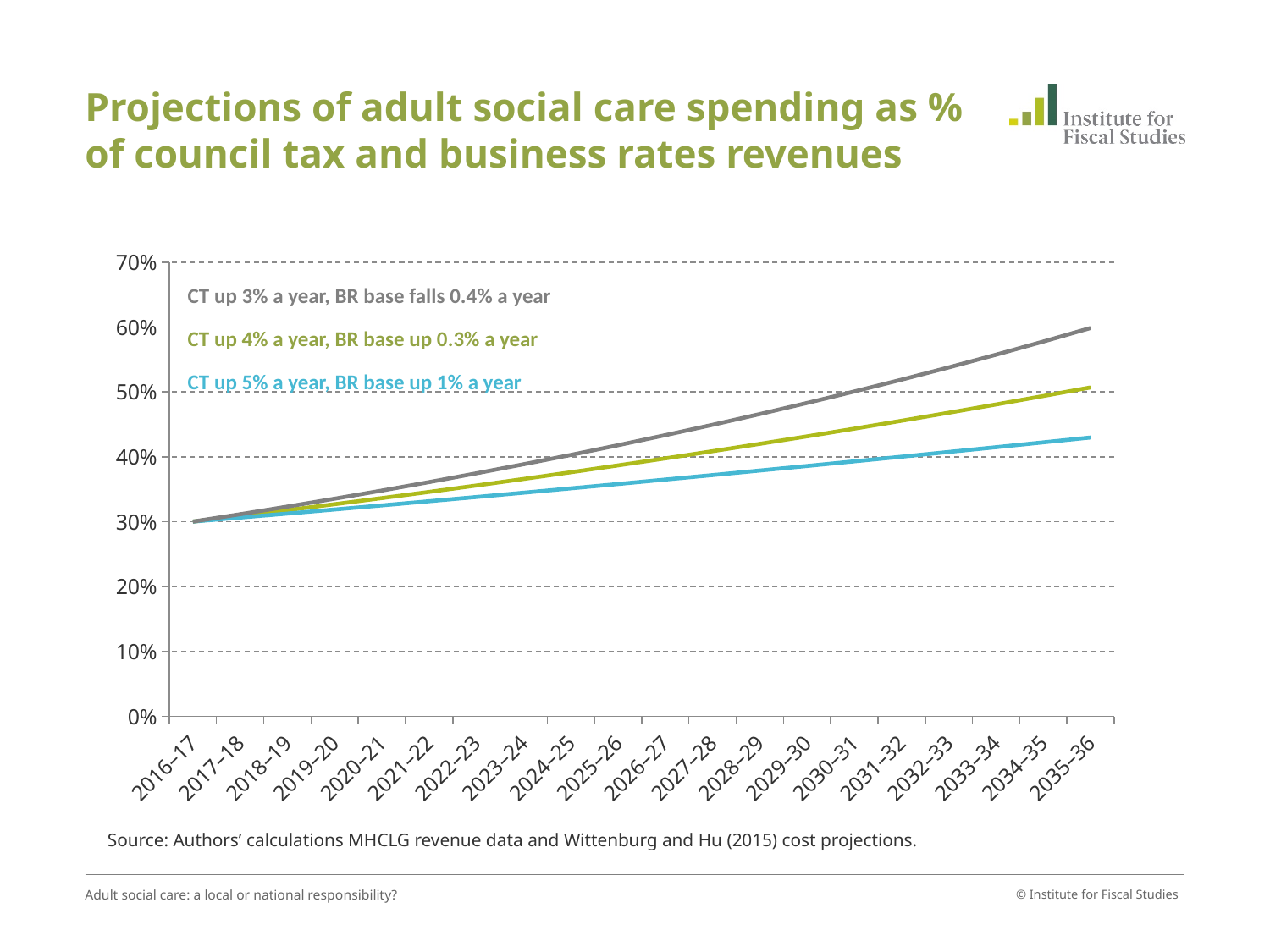
What colour is the line for the 'CT up 5% a year, BR base up 1% a year' scenario? Blue Is the value for 'CT up 3% a year, BR base falls 0.4% a year' in 2035-36 greater or less than 50%? greater Which scenario has the lowest value in 2035-36? CT up 5% a year, BR base up 1% a year Which scenario has the highest value in 2035-36? CT up 3% a year, BR base falls 0.4% a year What kind of chart is shown on the slide? Line chart How many series (scenarios) are plotted on the chart? 3 Is the value for 'CT up 5% a year, BR base up 1% a year' in 2035-36 greater or less than 50%? less What is the title of the chart? Projections of adult social care spending as % of council tax and business rates revenues Do the values for the 'CT up 4% a year, BR base up 0.3% a year' scenario rise or fall from 2016-17 to 2035-36? Rise In 2035-36, which is larger: the value for 'CT up 3% a year, BR base falls 0.4% a year' or the value for 'CT up 5% a year, BR base up 1% a year'? CT up 3% a year, BR base falls 0.4% a year How many years are shown along the x axis? 20 Is the value for 'CT up 4% a year, BR base up 0.3% a year' in 2025-26 greater or less than 40%? less